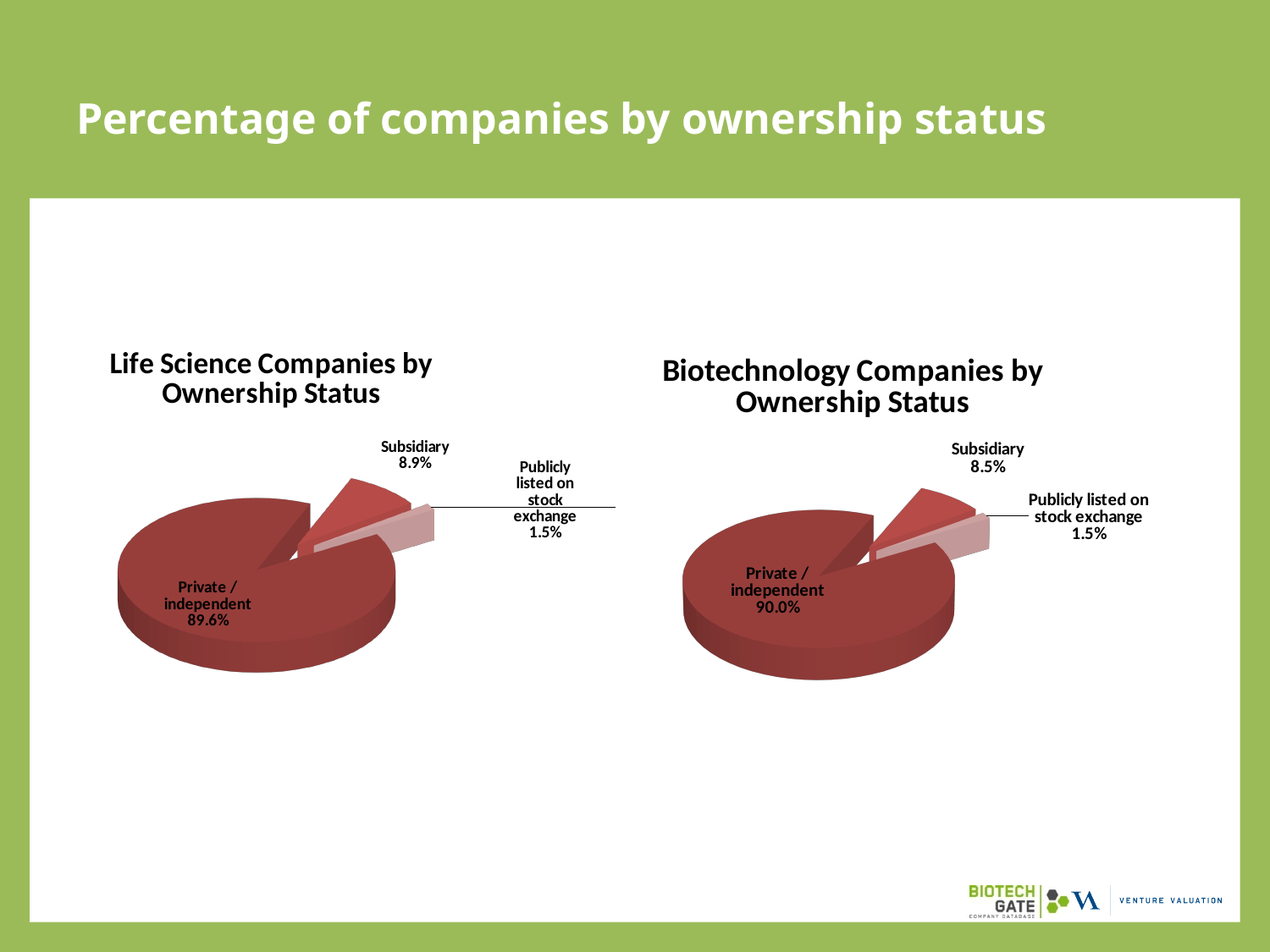
In the 'Life Science Companies by Ownership Status' chart, what percentage of companies are Subsidiary? 8.9% How many ownership categories are shown in the 'Biotechnology Companies by Ownership Status' chart? 3 In the 'Biotechnology Companies by Ownership Status' chart, what percentage of companies are Publicly listed on stock exchange? 1.5% In the 'Biotechnology Companies by Ownership Status' chart, what percentage of companies are Private / independent? 90.0% In the 'Life Science Companies by Ownership Status' chart, what is the difference in percentage points between the Subsidiary and Publicly listed on stock exchange shares? 7.4 What kind of chart is 'Life Science Companies by Ownership Status'? Pie chart In the 'Life Science Companies by Ownership Status' chart, what percentage of companies are Private / independent? 89.6% Which chart shows a larger Subsidiary share, 'Life Science Companies by Ownership Status' or 'Biotechnology Companies by Ownership Status'? Life Science Companies by Ownership Status What is the title of the slide? Percentage of companies by ownership status In the 'Life Science Companies by Ownership Status' chart, which ownership category has the largest share? Private / independent How many charts are shown on the slide? 2 In the 'Biotechnology Companies by Ownership Status' chart, which ownership category has the smallest share? Publicly listed on stock exchange